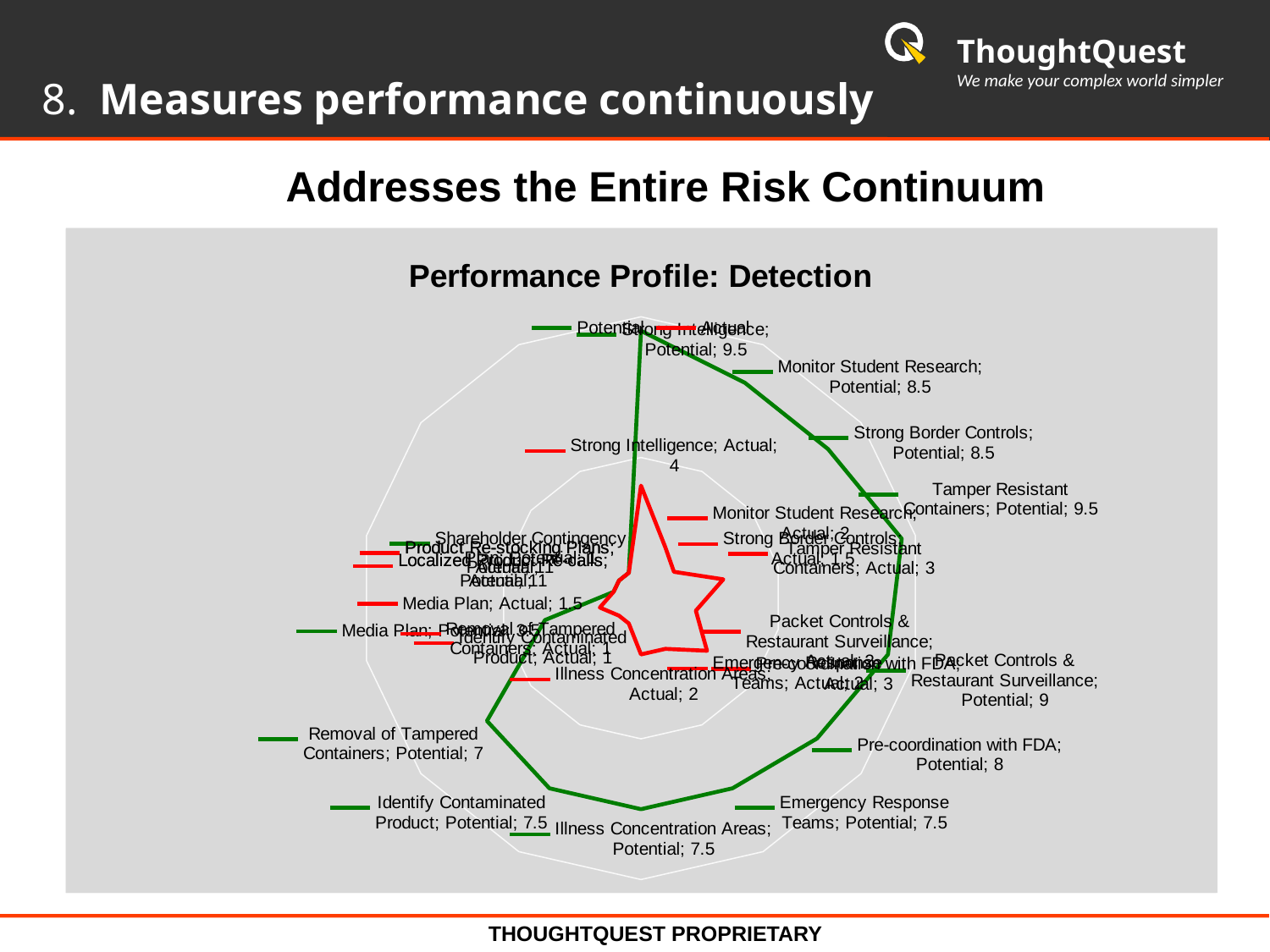
What is the title of the chart? Performance Profile: Detection What is the Potential value for Packet Controls & Restaurant Surveillance? 9 What type of chart is shown on the slide? Radar chart What is the Potential value for Monitor Student Research? 8.5 What is the Potential value for Tamper Resistant Containers? 9.5 Which is larger, the Potential value for Pre-coordination with FDA or the Potential value for Emergency Response Teams? Pre-coordination with FDA What is the Potential value for Removal of Tampered Containers? 7 What is the Actual value for Identify Contaminated Product? 1 What is the difference between the Potential and Actual values for Tamper Resistant Containers? 6.5 Which series is drawn in green? Potential What is the Actual value for Strong Intelligence? 4 How many series does the chart legend list? 2